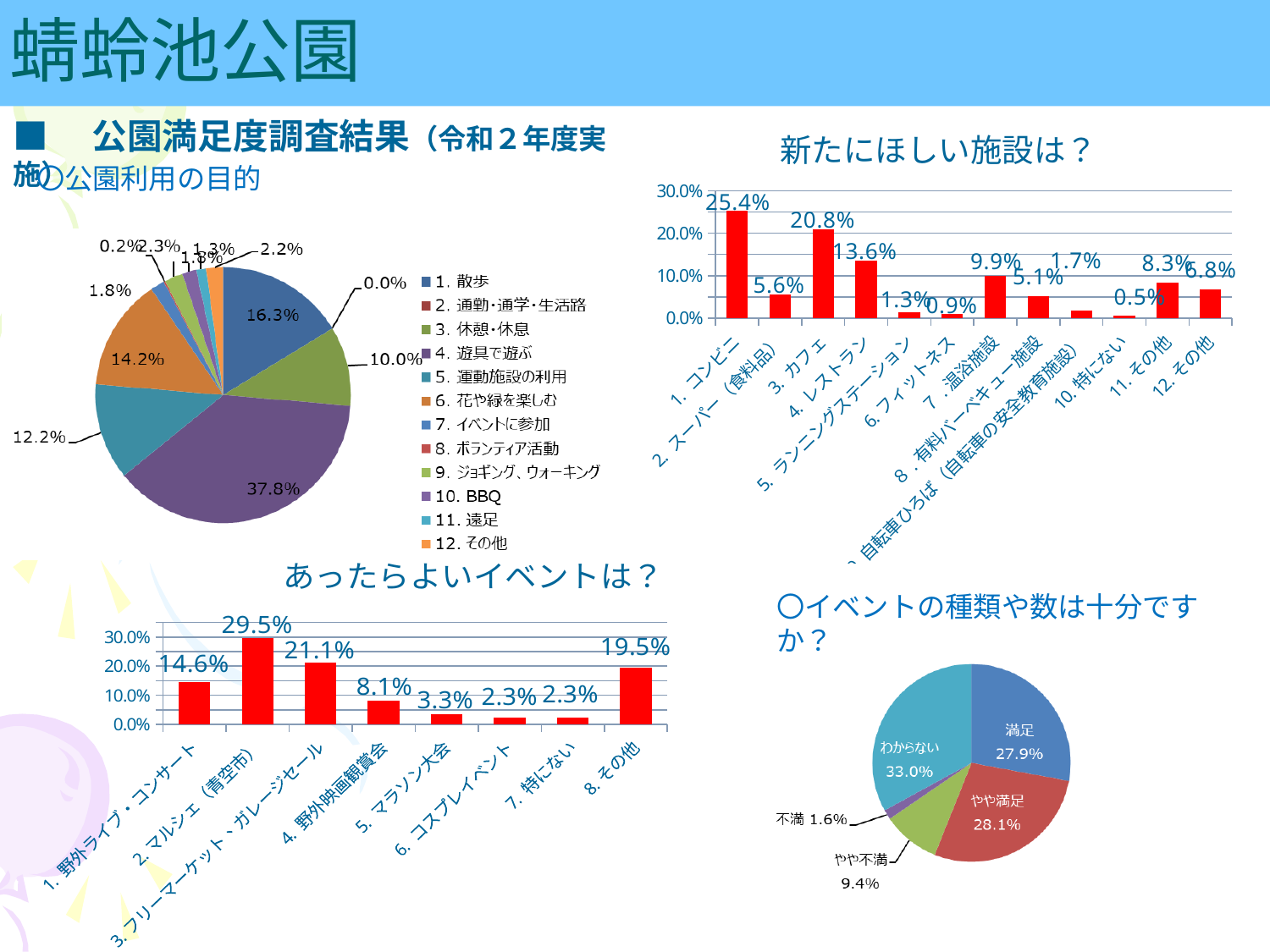
In the bar chart titled あったらよいイベントは？, what is the value for 8. その他? 19.5% In the bar chart titled 新たにほしい施設は？, which category has the lowest value? 10. 特にない In the pie chart titled 〇イベントの種類や数は十分ですか？, which slice is the smallest? 不満 In the bar chart titled 新たにほしい施設は？, what is the value for 1. コンビニ? 25.4% What kind of chart is the one titled あったらよいイベントは？? bar chart In the pie chart titled 〇イベントの種類や数は十分ですか？, what is the difference between やや満足 and やや不満? 18.7% In the pie chart titled 〇イベントの種類や数は十分ですか？, what share does わからない have? 33.0% In the bar chart titled 新たにほしい施設は？, what is the difference between 3. カフェ and 4. レストラン? 7.2% How many entries does the legend of the pie chart under 〇公園利用の目的 list? 12 How many categories are shown in the bar chart titled 新たにほしい施設は？? 12 In the bar chart titled あったらよいイベントは？, which category has the highest value? 2. マルシェ（青空市） In the bar chart titled あったらよいイベントは？, which is larger: 1. 野外ライブ・コンサート or 4. 野外映画観賞会? 1. 野外ライブ・コンサート